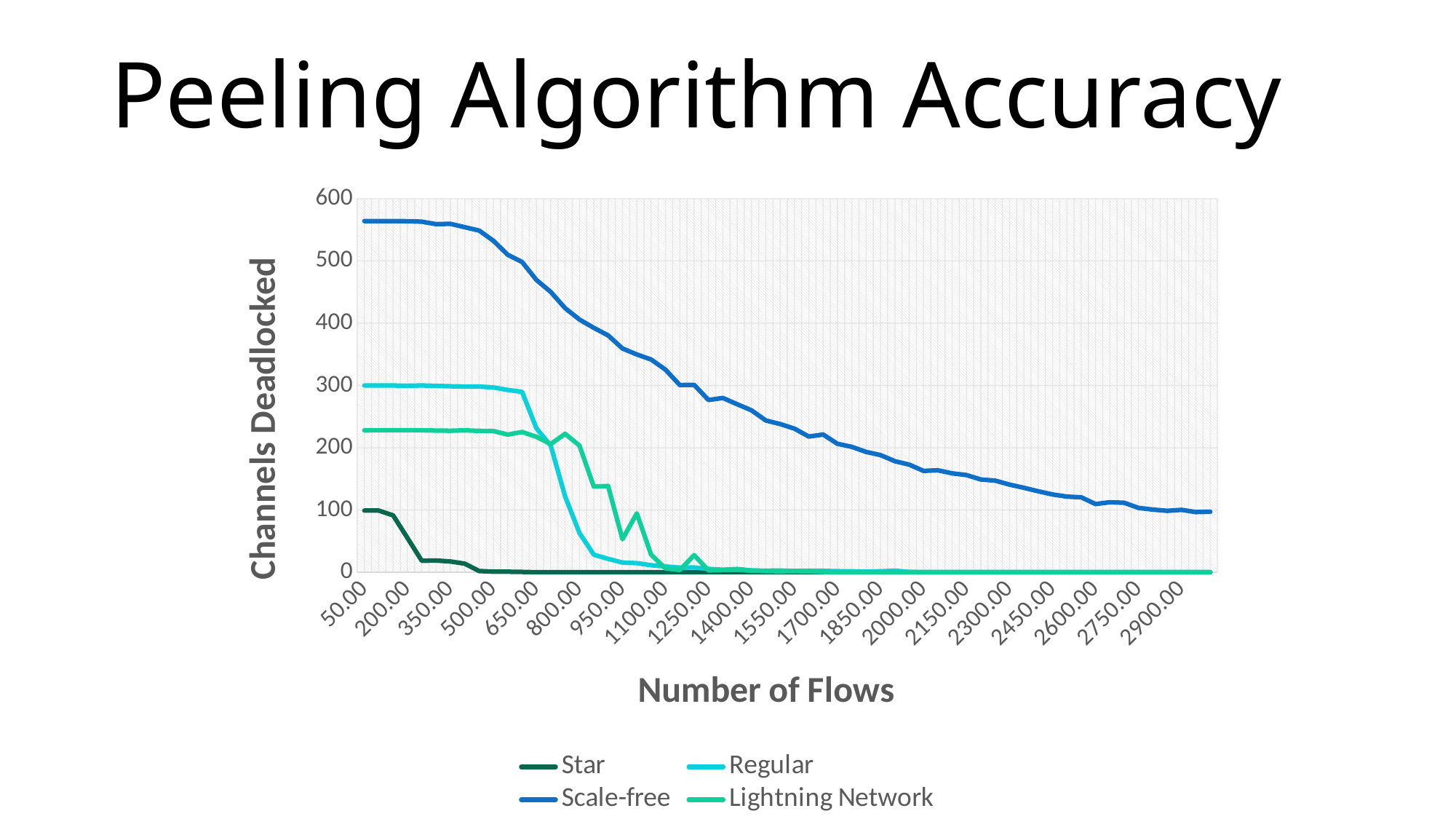
Which series has the lowest number of channels deadlocked at 50.00 flows? Star Does the Scale-free series rise or fall as the number of flows increases? fall Is the value for Regular at 50.00 flows greater or less than 200? greater What is the title of the chart? Peeling Algorithm Accuracy What is the label of the vertical axis? Channels Deadlocked Is the value for Star at 50.00 flows greater or less than 200? less Which series has the highest number of channels deadlocked at 50.00 flows? Scale-free Is the value for Scale-free at 50.00 flows greater or less than 500? greater What kind of chart is shown on the slide? line chart How many series does the legend list? 4 At 50.00 flows, which series has more channels deadlocked, Scale-free or Regular? Scale-free